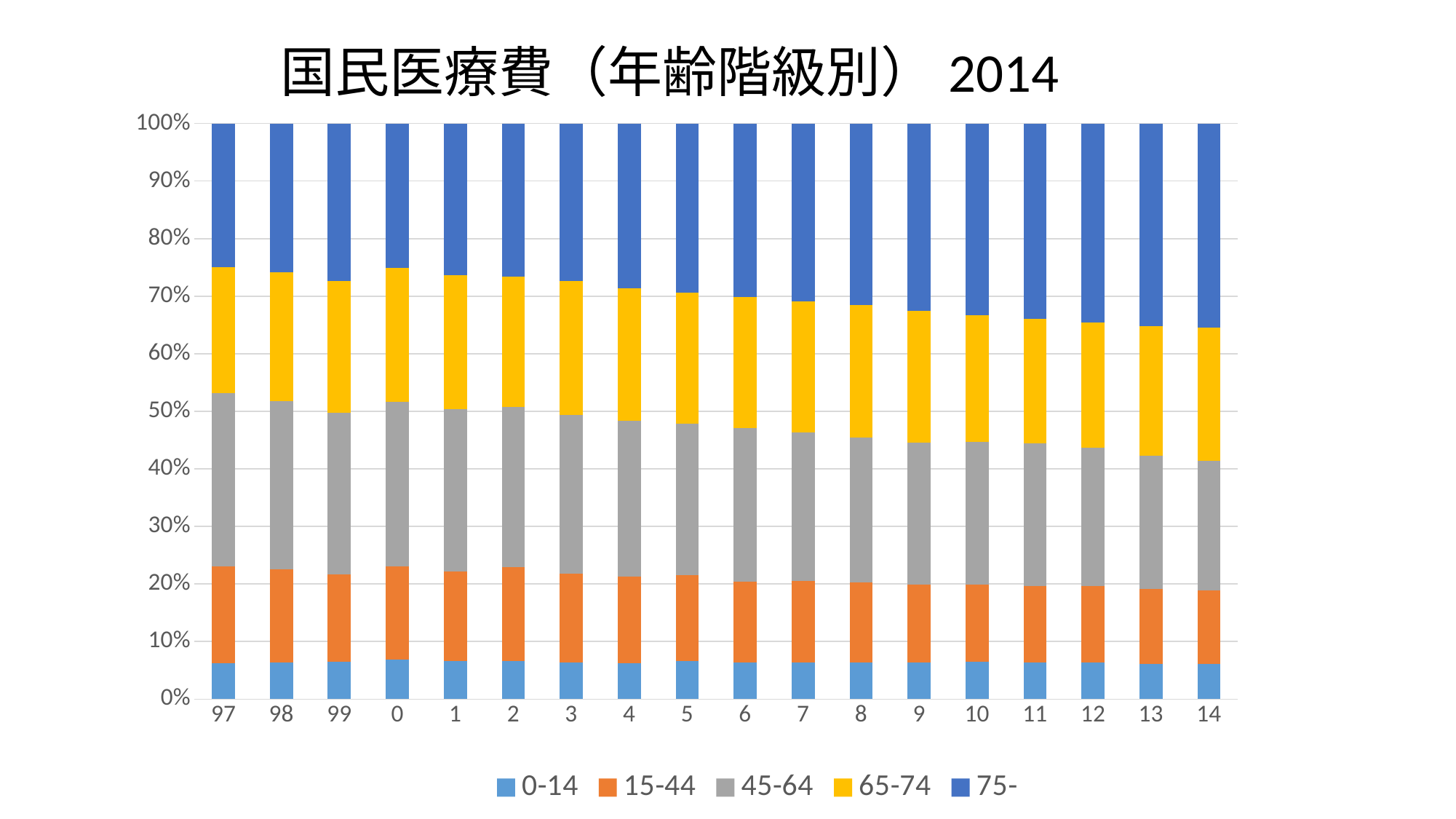
Is the share of the 75- series in 97 greater or less than 30%? less What is the title of the chart? 国民医療費（年齢階級別） 2014 How many series does the legend list? 5 Which year has the larger share for the 75- series, 97 or 14? 14 Is the share of the 75- series in 14 greater or less than 30%? greater Does the share of the 45-64 series rise or fall from 97 to 14? fall Does the share of the 75- series rise or fall from 97 to 14? rise Is the share of the 15-44 series in 14 greater or less than 10%? greater What kind of chart is shown on the slide? stacked bar chart How many year categories are shown on the x axis? 18 Which series is shown in yellow in the legend? 65-74